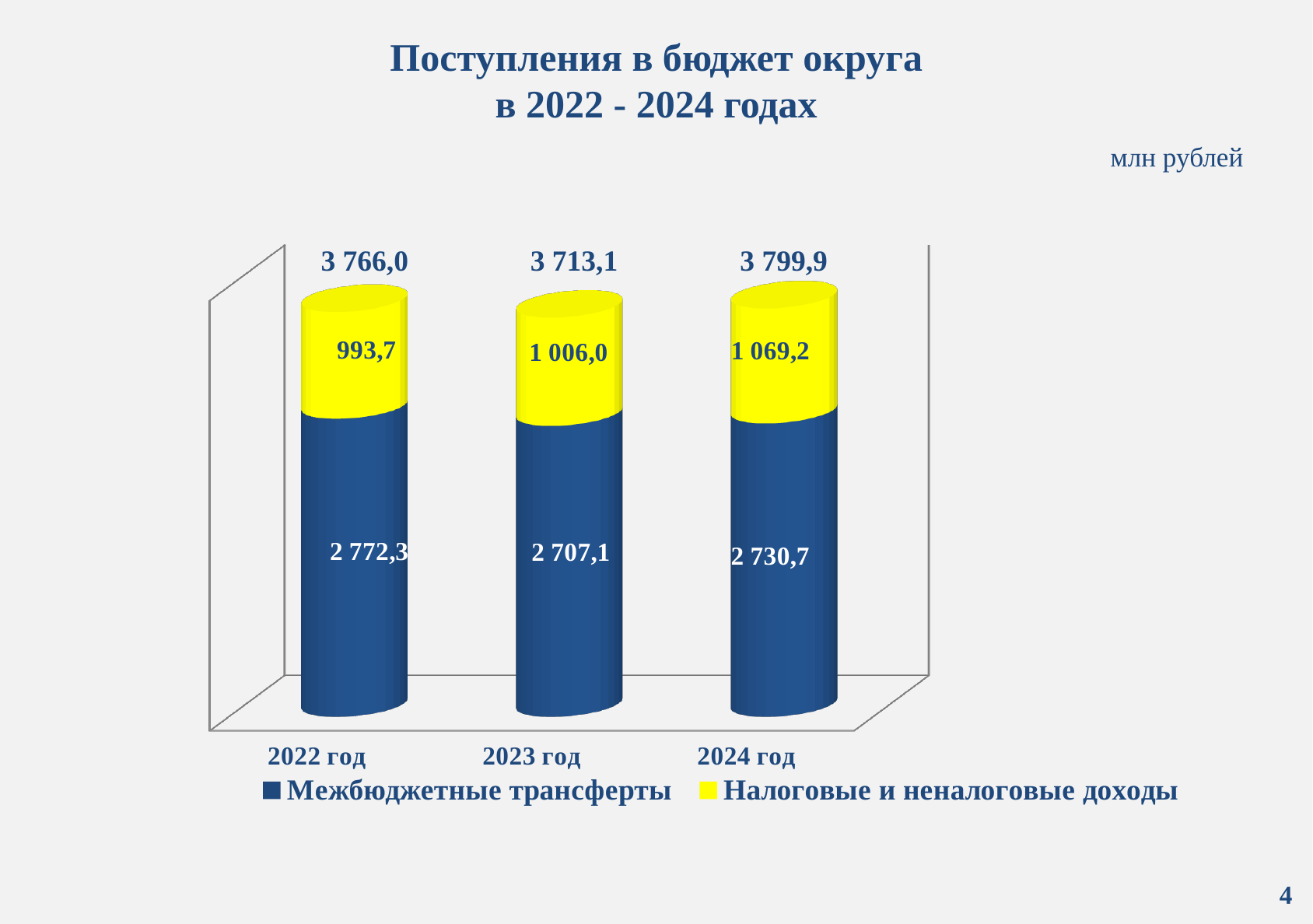
What is the value of Налоговые и неналоговые доходы for 2024 год? 1 069,2 Which year has the lowest value of Межбюджетные трансферты? 2023 год Which is larger: Межбюджетные трансферты in 2022 год or in 2024 год? 2022 год How many series does the legend list? 2 What is the value of Межбюджетные трансферты for 2022 год? 2 772,3 Do the values of Налоговые и неналоговые доходы rise or fall from 2022 год to 2024 год? Rise What kind of chart is shown on the slide? Stacked bar chart How many years (categories) are shown on the chart? 3 Which year has the highest total поступления? 2024 год What is the difference between Налоговые и неналоговые доходы in 2024 год and 2022 год? 75,5 What unit of measurement is indicated on the slide? млн рублей What is the total shown above the bar for 2023 год? 3 713,1